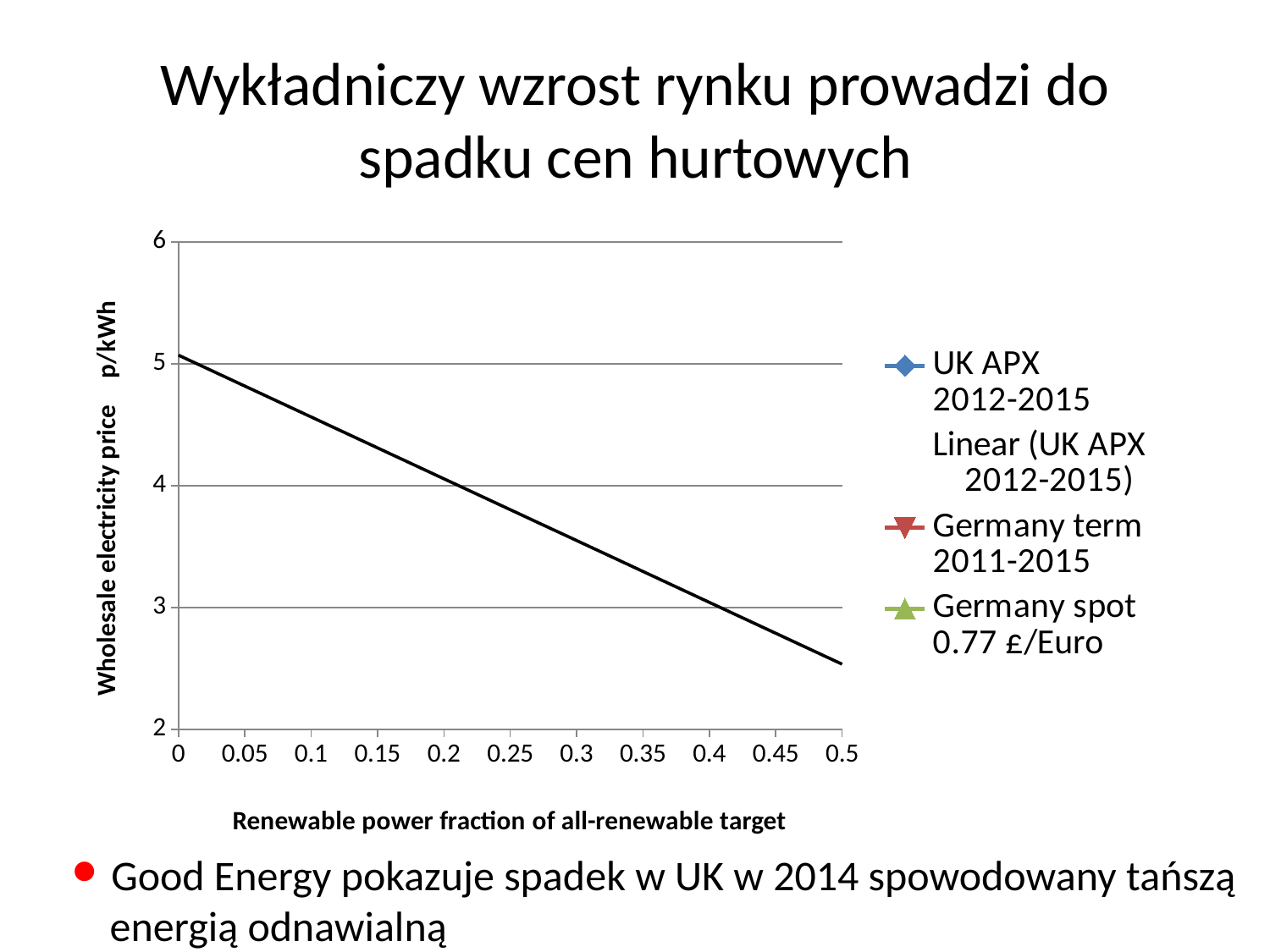
What is the lowest value shown on the chart's y axis? 2 How many entries does the chart's legend list? 4 What is the title of the x axis on the chart? Renewable power fraction of all-renewable target What is the highest value shown on the chart's y axis? 6 How many tick labels are shown along the chart's x axis? 11 Is the value of the plotted line at a renewable power fraction of 0.5 greater or less than 3? less Does the plotted line rise or fall as the renewable power fraction increases along the x axis? fall Is the value of the plotted line at a renewable power fraction of 0.1 greater or less than 4? greater Is the plotted line higher at a renewable power fraction of 0 or at 0.5? 0 What is the title of the y axis on the chart? Wholesale electricity price p/kWh Is the value of the plotted line at a renewable power fraction of 0.25 greater or less than 4? less